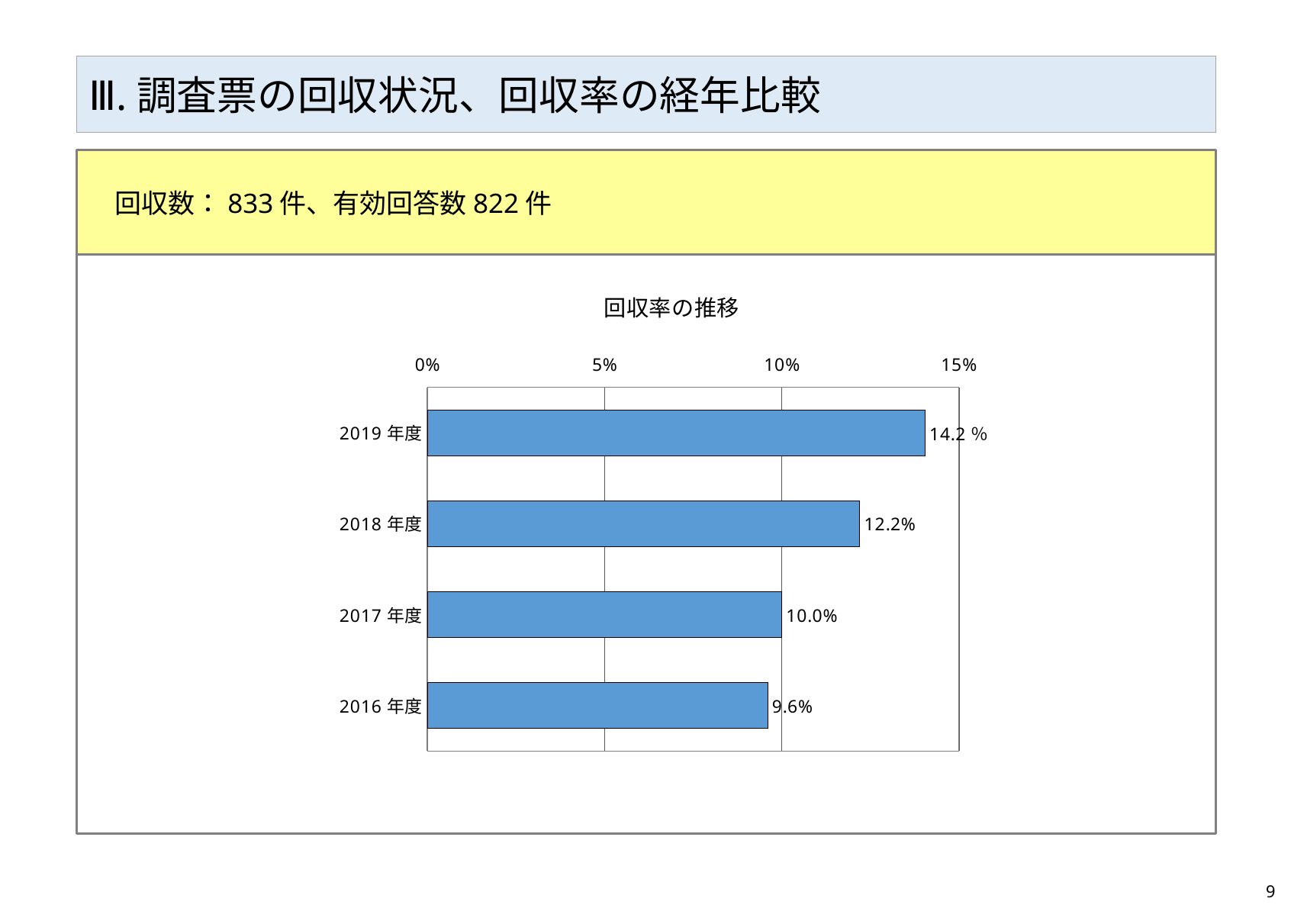
What is the value for 2019 年度? 14.2 % What is the value for 2016 年度? 9.6% What is the value for 2018 年度? 12.2% What is the title of the chart? 回収率の推移 Which year has the highest value? 2019 年度 What kind of chart is this? Bar chart Which year has the lowest value? 2016 年度 Which is larger, the value for 2018 年度 or the value for 2017 年度? 2018 年度 What is the value for 2017 年度? 10.0% What is the difference between the values for 2017 年度 and 2016 年度? 0.4% How many years are shown in the chart? 4 What is the difference between the values for 2019 年度 and 2018 年度? 2.0%